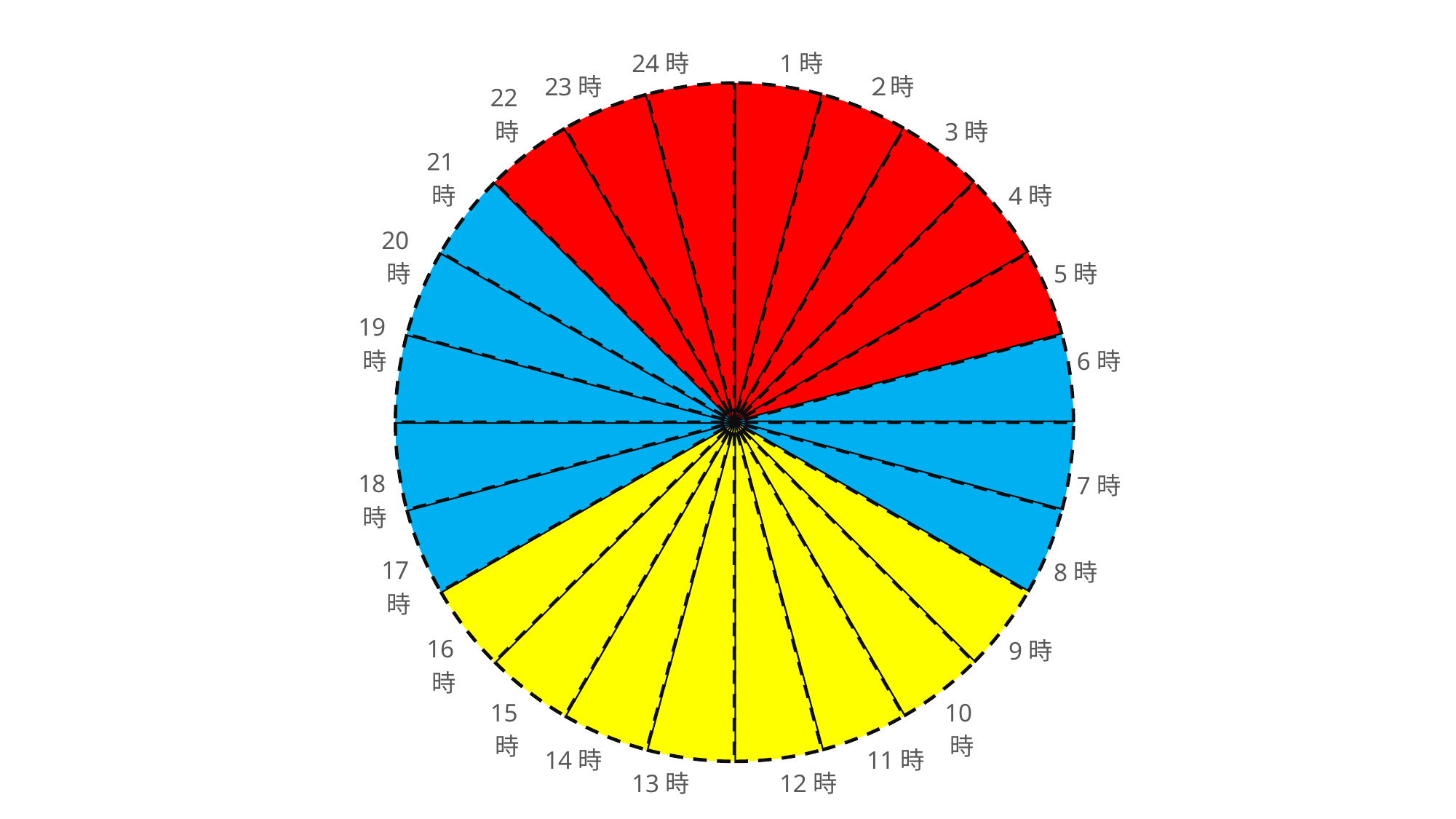
How many categories (hour labels) are shown around the chart? 24 Which hour label comes immediately after 11時 going clockwise? 12時 What colour is the slice labelled 3時? Red What is the label of the first category at the top of the chart, just right of 24時? 1時 What colour is the slice labelled 12時? Yellow